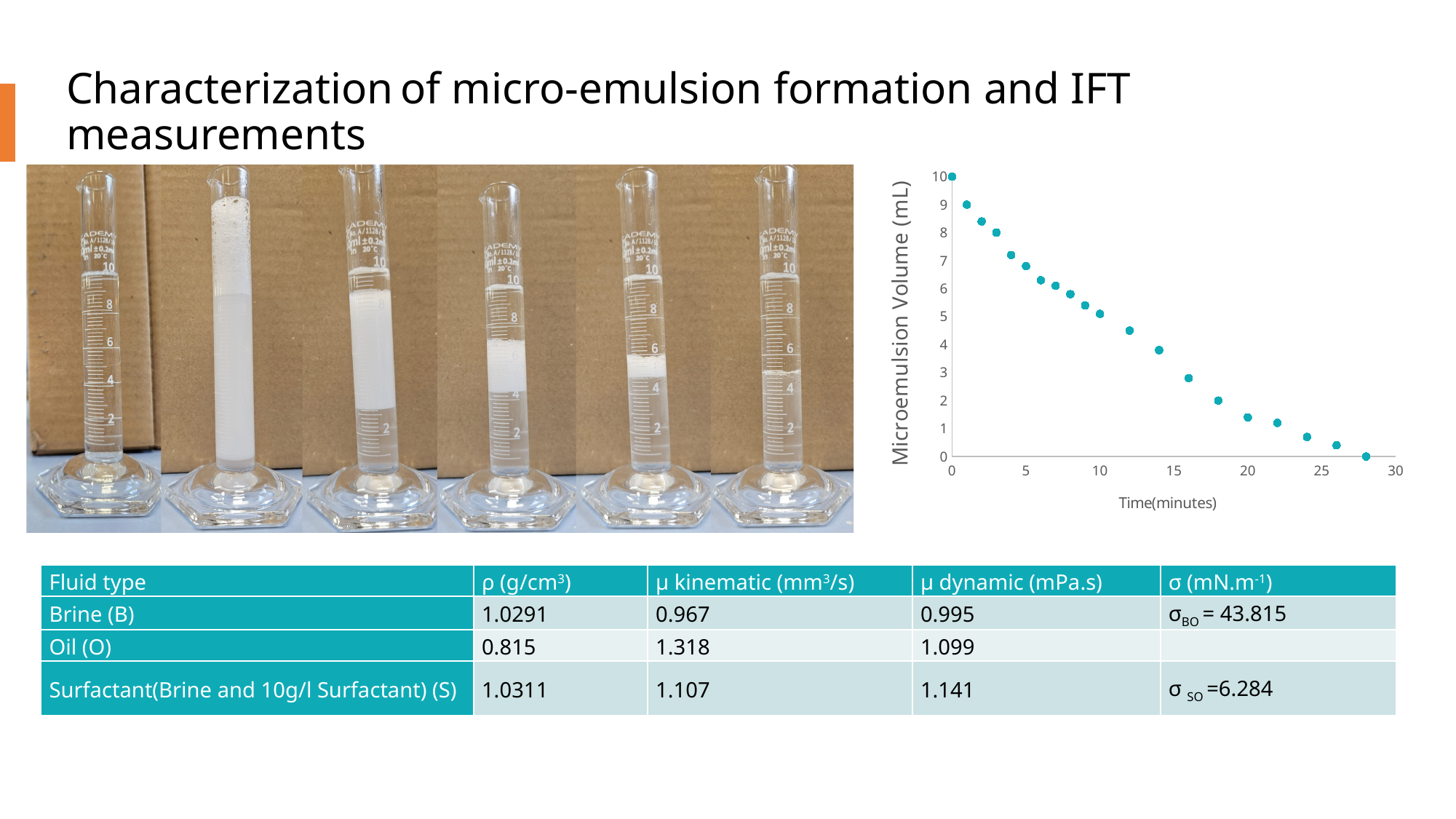
Do the plotted values rise or fall as time increases along the x axis? fall Is the microemulsion volume at 4 minutes greater or less than 6 mL? greater Which time has the highest microemulsion volume, 0 minutes or 28 minutes? 0 minutes Is the microemulsion volume at 24 minutes greater or less than 1 mL? less What is the label of the y axis of the chart? Microemulsion Volume (mL) Is the microemulsion volume at 10 minutes greater or less than 6 mL? less How many data points are plotted on the chart? 20 At which plotted time is the microemulsion volume lowest? 28 minutes What is the label of the x axis of the chart? Time(minutes) What kind of chart is shown on the slide? scatter chart